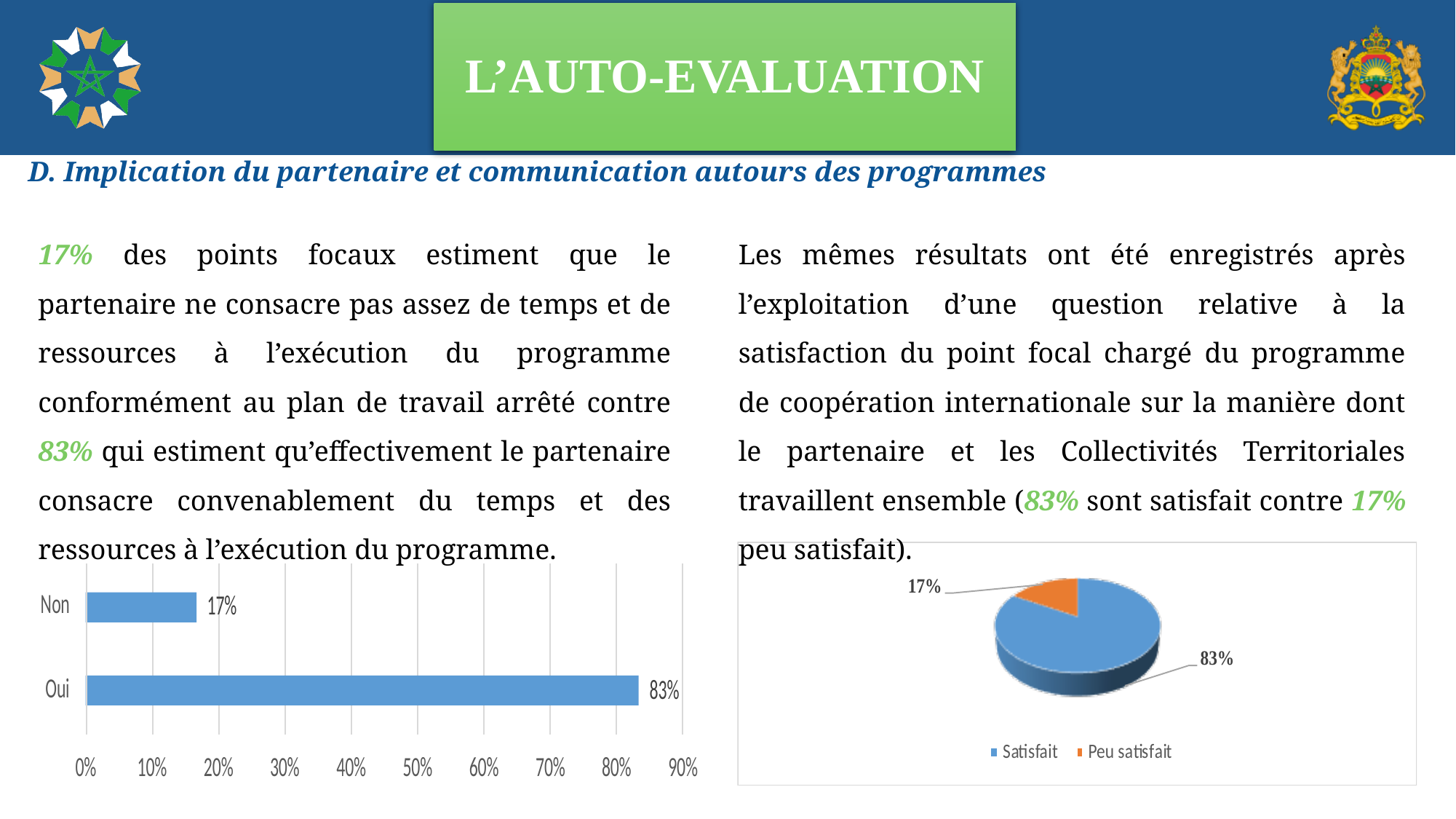
In the bar chart on the left, which category has the lowest value? Non In the pie chart on the right, what share does Satisfait have? 83% In the bar chart on the left, what is the difference between the values for Oui and Non? 66% What kind of chart is shown on the left of the slide? bar chart In the bar chart on the left, which category has the highest value? Oui In the bar chart on the left, what is the value for Oui? 83% In the pie chart on the right, which slice is larger, Satisfait or Peu satisfait? Satisfait In the pie chart on the right, what share does Peu satisfait have? 17% In the bar chart on the left, is the value for Oui greater or less than 80%? greater In the pie chart on the right, how many entries does the legend list? 2 In the bar chart on the left, what is the value for Non? 17% In the bar chart on the left, how many categories are shown? 2